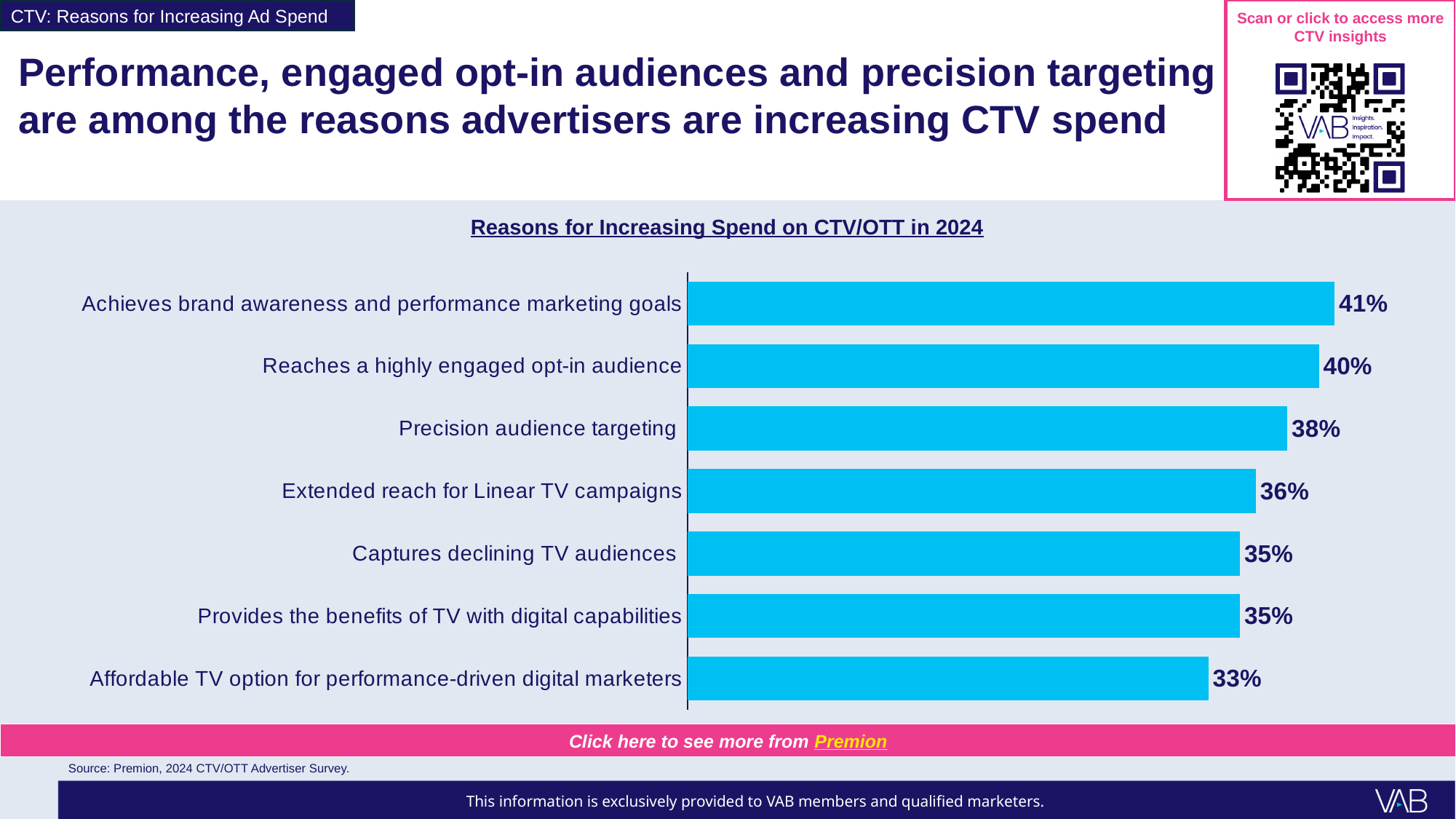
What kind of chart is shown on the slide? Bar chart Which two reasons share the same value of 35%? Captures declining TV audiences; Provides the benefits of TV with digital capabilities How many reasons are shown in the chart? 7 What percentage of advertisers cited 'Precision audience targeting' as a reason for increasing spend on CTV/OTT in 2024? 38% What is the value for 'Extended reach for Linear TV campaigns'? 36% What is the difference between 'Reaches a highly engaged opt-in audience' and 'Precision audience targeting'? 2% Which reason has the highest percentage in the chart? Achieves brand awareness and performance marketing goals What is the difference between the values for 'Achieves brand awareness and performance marketing goals' and 'Affordable TV option for performance-driven digital marketers'? 8% Which reason has the lowest percentage in the chart? Affordable TV option for performance-driven digital marketers Which is larger: the value for 'Reaches a highly engaged opt-in audience' or the value for 'Captures declining TV audiences'? Reaches a highly engaged opt-in audience What is the value for 'Affordable TV option for performance-driven digital marketers'? 33% What is the title of the chart? Reasons for Increasing Spend on CTV/OTT in 2024